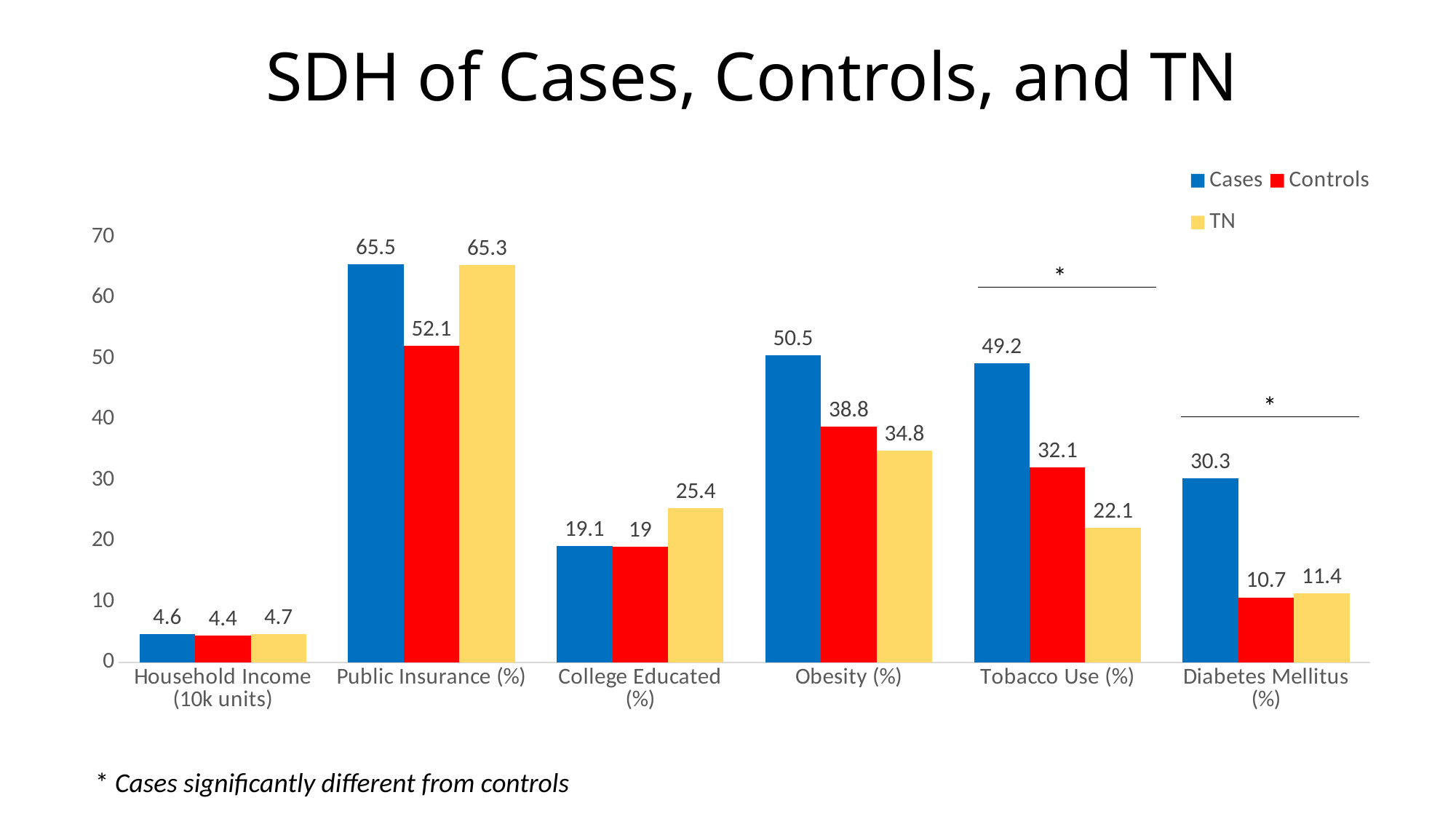
What is the value for Controls in the Obesity (%) category? 38.8 What is the value for Cases in the Diabetes Mellitus (%) category? 30.3 What is the difference between the Cases and Controls values in the Tobacco Use (%) category? 17.1 What is the title of the chart? SDH of Cases, Controls, and TN How many categories are shown on the x axis? 6 Which category has the lowest value for the TN series? Household Income (10k units) Which is larger in the College Educated (%) category: the TN value or the Cases value? TN How many series does the legend list? 3 What is the value for TN in the Tobacco Use (%) category? 22.1 Which category has the highest value for the Cases series? Public Insurance (%) What kind of chart is shown on the slide? Bar chart What is the value for Cases in the Public Insurance (%) category? 65.5